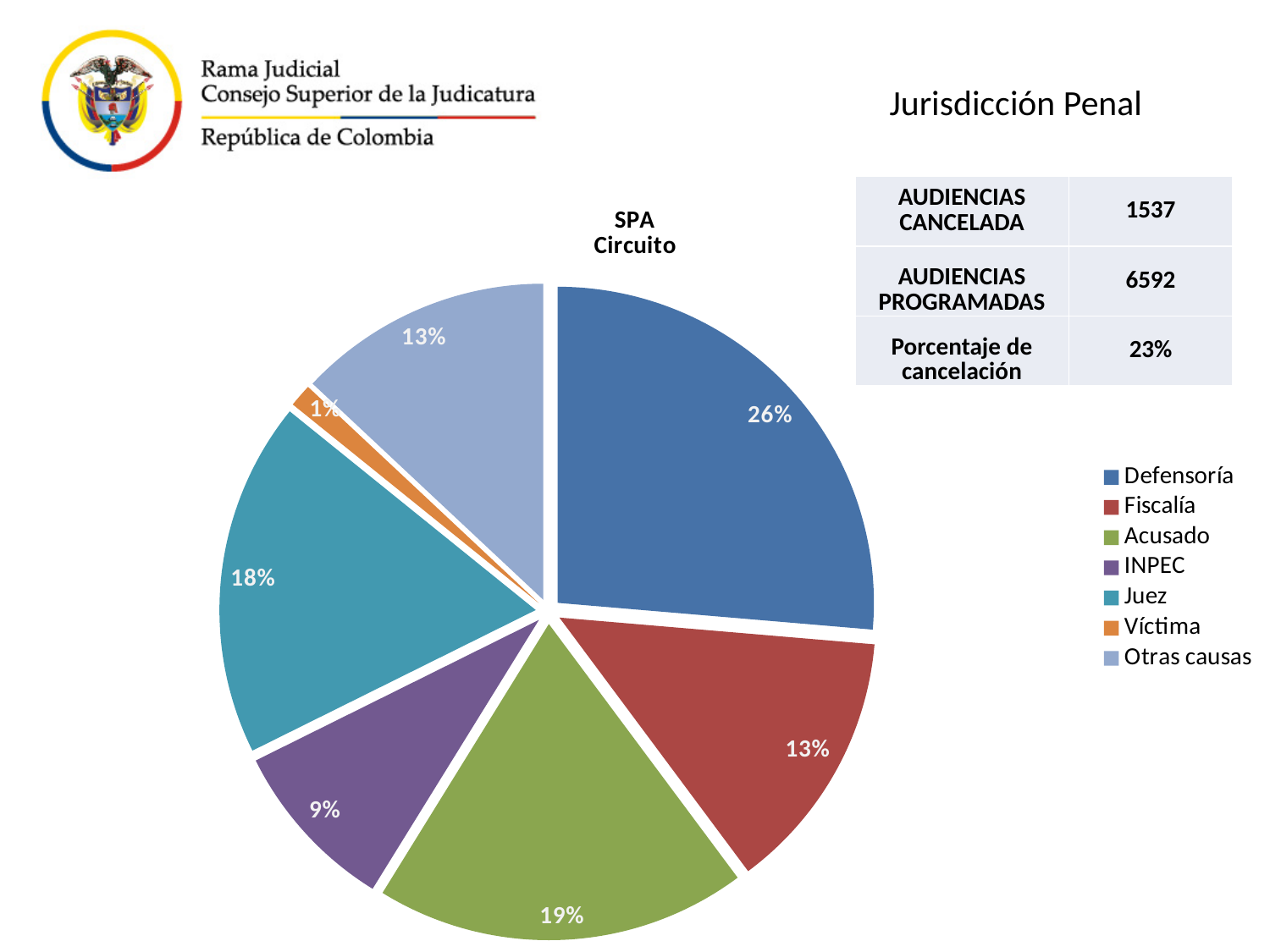
Which category has the largest slice of the pie? Defensoría What share of the pie does INPEC represent? 9% Which category has the smallest slice of the pie? Víctima What share of the pie does Víctima represent? 1% What share of the pie does Acusado represent? 19% Which slice is larger, Acusado or Juez? Acusado What is the title of the pie chart? SPA Circuito What kind of chart is shown on the slide? pie chart How many categories does the legend list? 7 What is the difference in percentage points between the Defensoría slice and the Fiscalía slice? 13